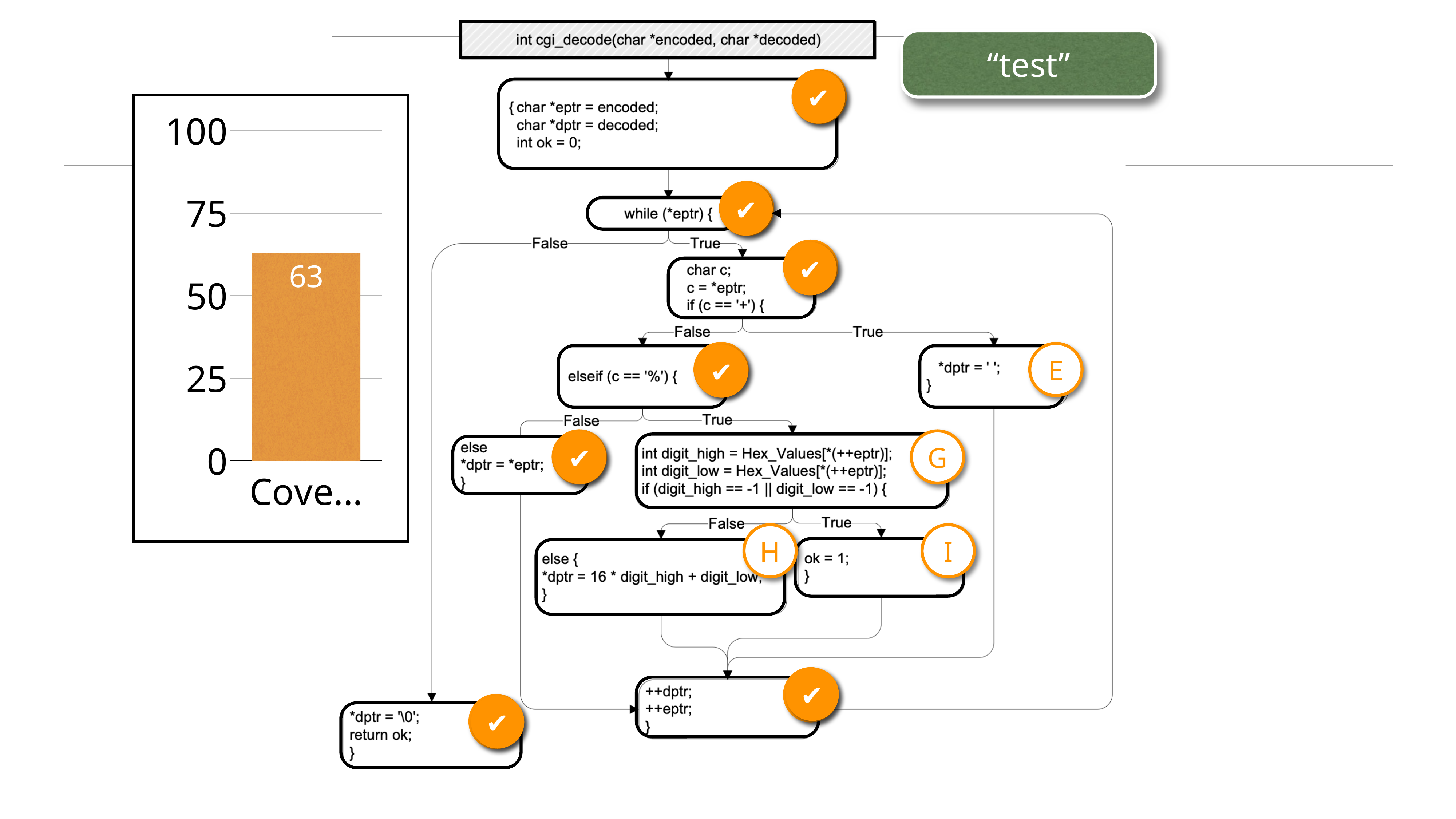
Is the value of the bar greater or less than 50? greater What colour is the bar in the chart? orange What is the lowest value shown on the chart's vertical axis? 0 How far below 100 is the value of the bar? 37 What is the highest value shown on the chart's vertical axis? 100 What kind of chart is shown on the left of the slide? bar chart Is the value of the bar greater or less than 75? less What value is shown on the bar in the chart? 63 How many bars does the chart contain? 1